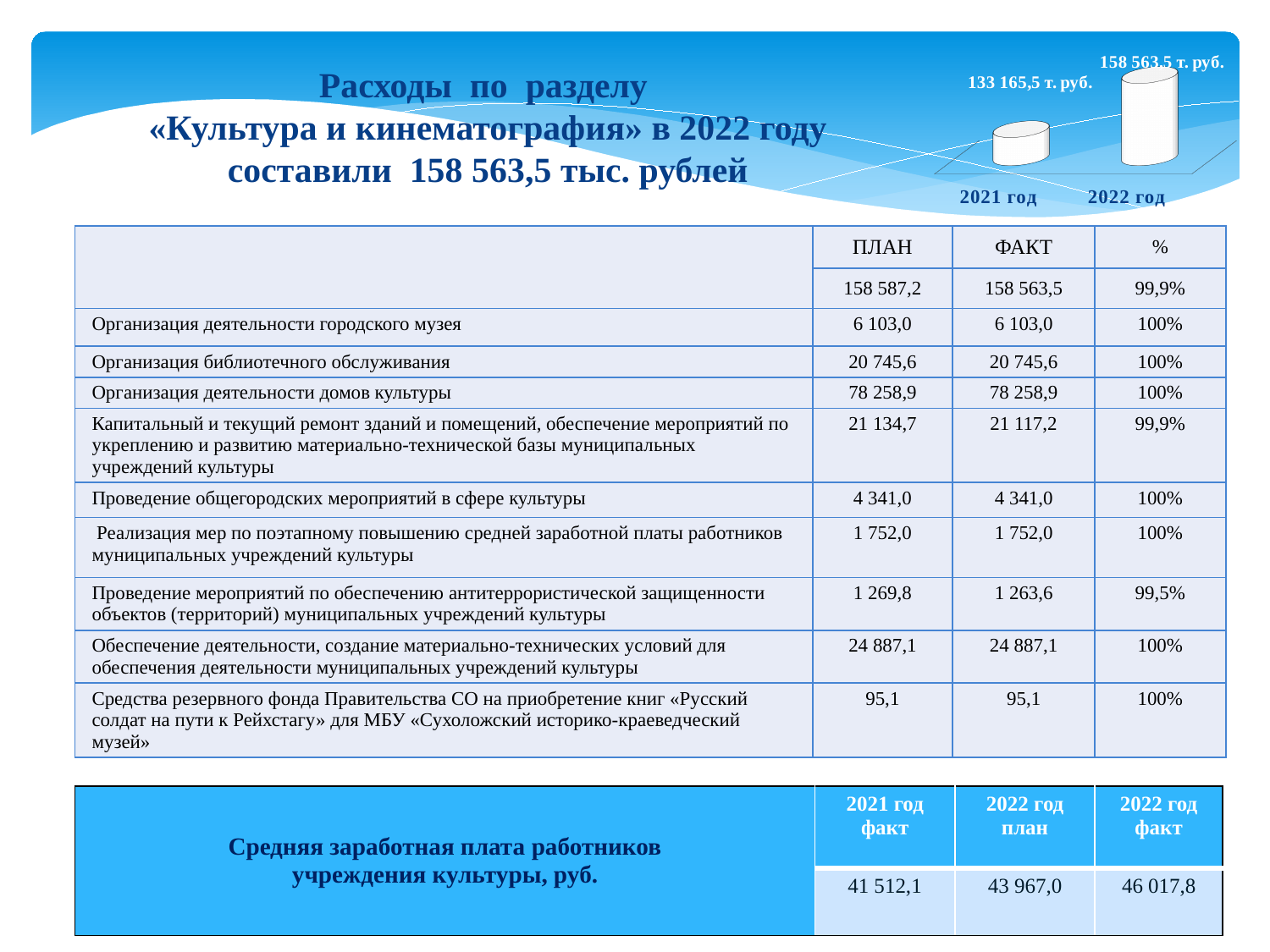
Which year has the lower value in the chart? 2021 год Which year has the higher value in the chart? 2022 год Do the values in the chart rise or fall from 2021 год to 2022 год? rise What unit is used for the data labels in the chart? т. руб. What kind of chart is shown in the top right of the slide? bar chart By how much does the 2022 год value exceed the 2021 год value in the chart? 25 398,0 т. руб. Is the value for 2022 год larger or smaller than the value for 2021 год? larger What value does the chart show for 2022 год? 158 563,5 т. руб. How many categories (years) are plotted in the chart? 2 What value does the chart show for 2021 год? 133 165,5 т. руб.